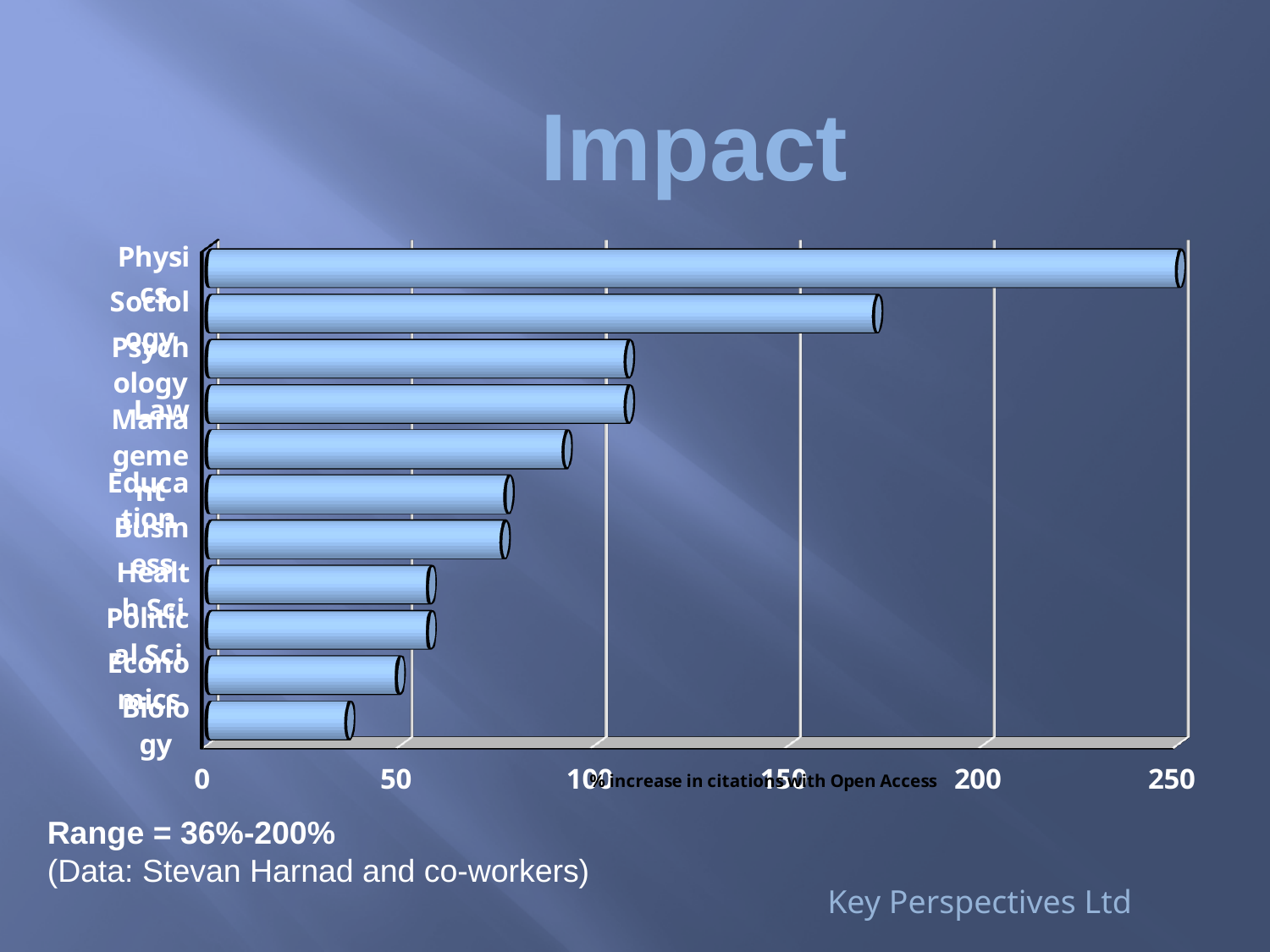
What kind of chart is shown on the slide? bar chart Which has a larger value, Sociology or Psychology? Sociology What is the label of the horizontal axis? % increase in citations with Open Access Which has a larger value, Management or Health Sci? Management Which discipline has the highest % increase in citations with Open Access? Physics Is the value for Education greater or less than 50? greater Is the value for Biology greater or less than 50? less Is the value for Management greater or less than 100? less Which discipline has the lowest % increase in citations with Open Access? Biology How many categories (disciplines) are plotted in the chart? 11